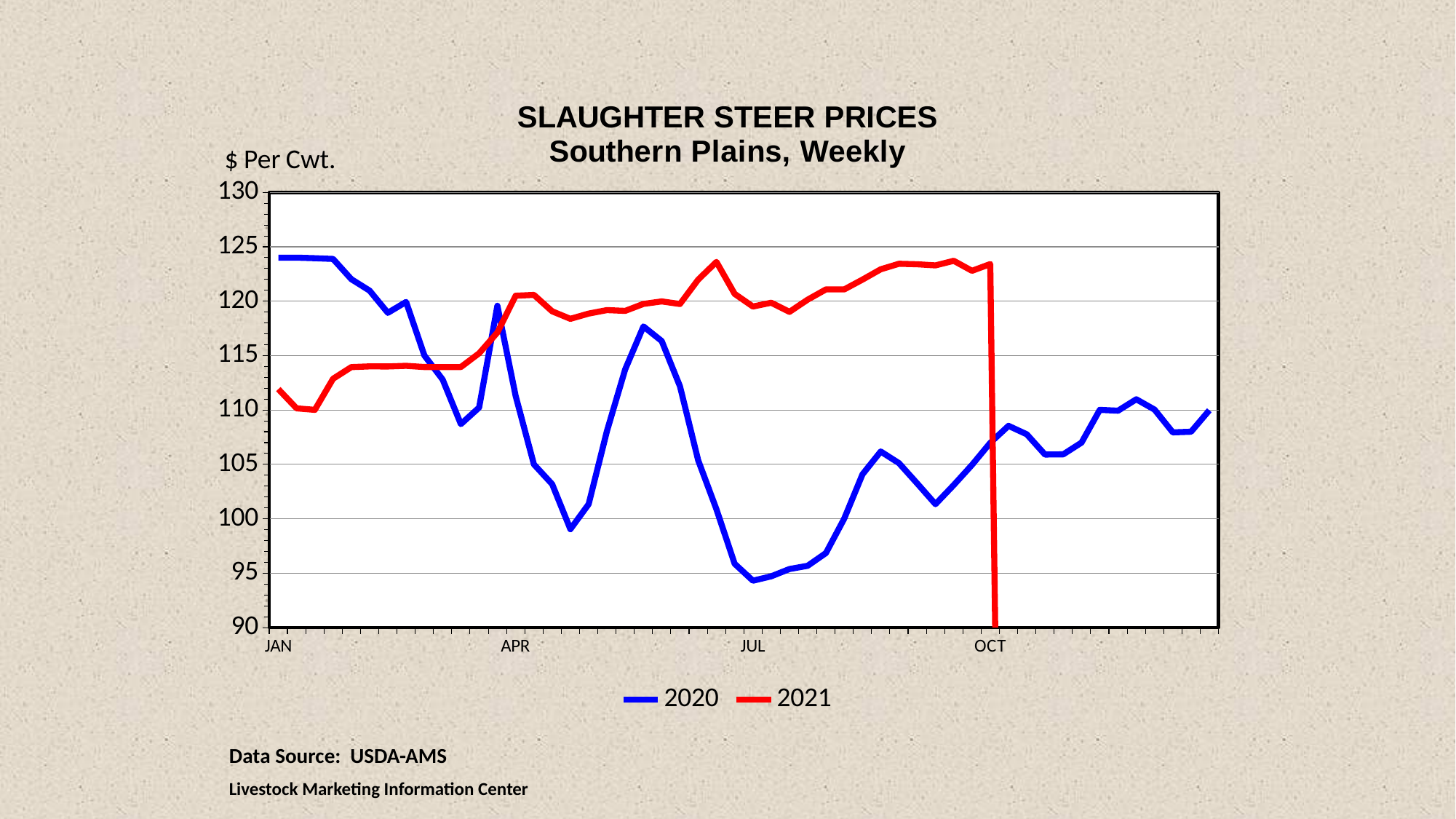
What unit is shown on the vertical axis label? $ Per Cwt. Which series has the higher value at JUL, 2020 or 2021? 2021 Which series has the higher value at JAN, 2020 or 2021? 2020 What is the title of the chart? SLAUGHTER STEER PRICES Southern Plains, Weekly How many series does the legend list? 2 What kind of chart is shown on the slide? line chart Around which month label does the 2020 series reach its lowest point? JUL Is the 2020 value at JAN greater or less than 120? greater Is the 2020 value at JUL greater or less than 100? less Is the 2021 value at JAN greater or less than 115? less Does the 2021 series generally rise or fall from JAN to OCT? rise